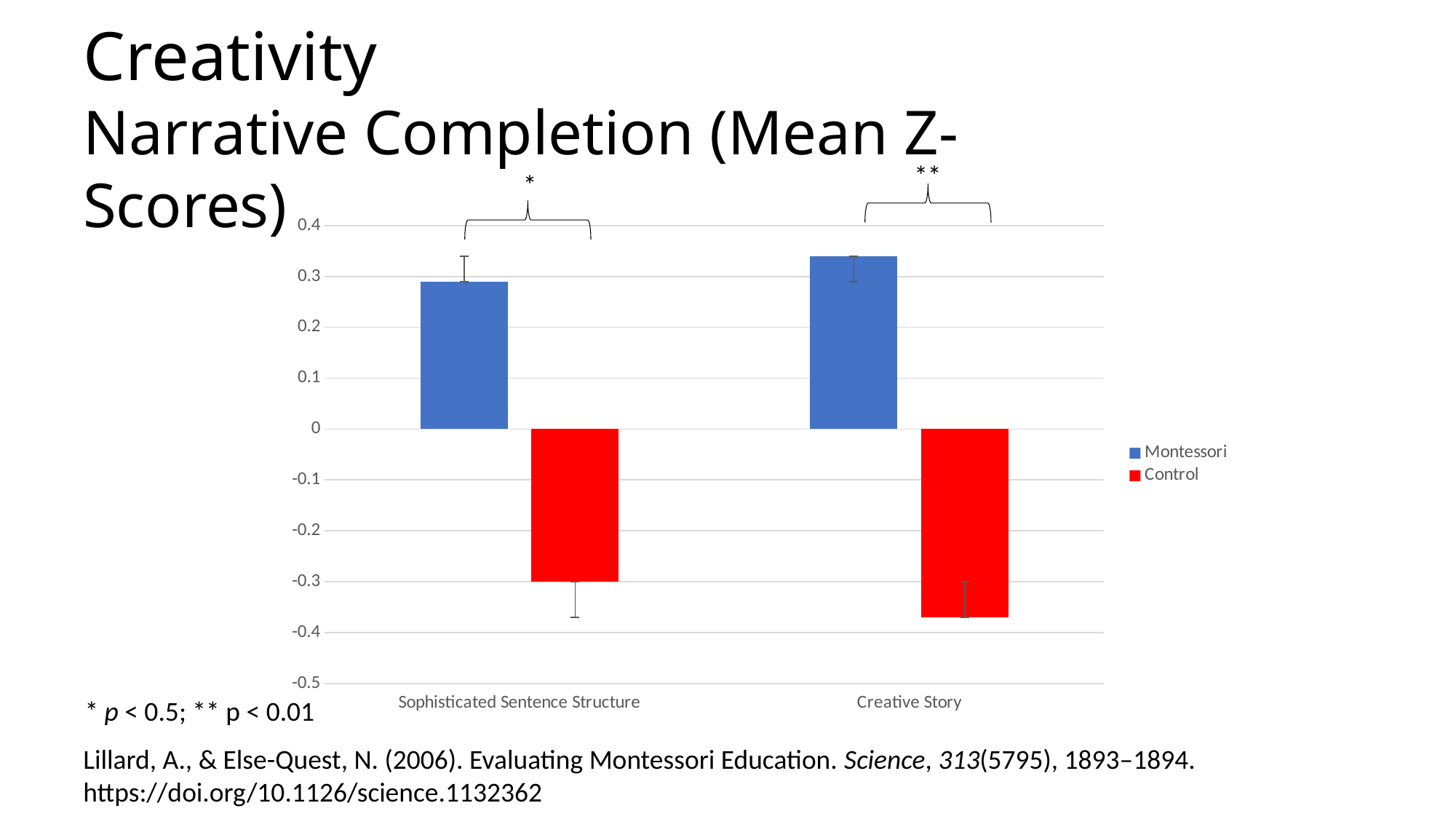
How many series does the chart's legend list? 2 What kind of chart is shown on the slide? Bar chart Which series is shown in red in the chart? Control Which bar in the chart has the highest value? Montessori, Creative Story Which is larger for the Montessori series: the value for Sophisticated Sentence Structure or the value for Creative Story? Creative Story Which series is shown in blue in the chart? Montessori Which bar in the chart has the lowest value? Control, Creative Story Is the Control value for Sophisticated Sentence Structure greater or less than -0.2? less How many categories are shown on the x axis of the chart? 2 Is the Montessori value for Creative Story greater or less than 0.3? greater Is the Control value for Creative Story greater or less than -0.3? less